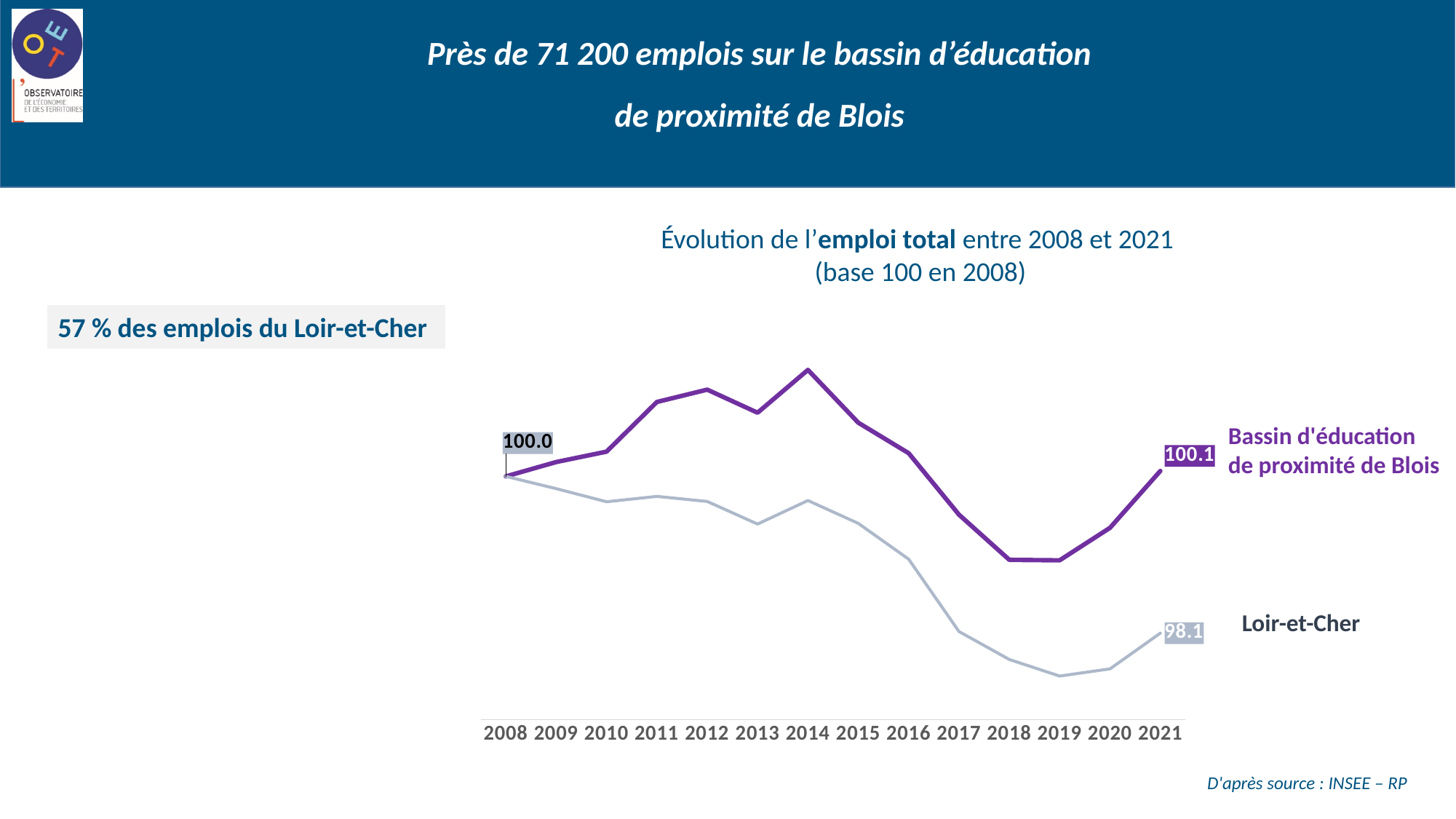
In which year does the Loir-et-Cher series reach its lowest point? 2019 What is the value for Bassin d'éducation de proximité de Blois in 2021? 100.1 What colour is the line for Bassin d'éducation de proximité de Blois? purple Does the Loir-et-Cher series rise or fall between 2016 and 2019? fall What is the difference between the 2021 values for Bassin d'éducation de proximité de Blois and Loir-et-Cher? 2.0 What is the value for Loir-et-Cher in 2021? 98.1 In which year does the Bassin d'éducation de proximité de Blois series reach its highest point? 2014 In 2021, which series has the higher value, Bassin d'éducation de proximité de Blois or Loir-et-Cher? Bassin d'éducation de proximité de Blois What kind of chart is shown on the slide? line chart How many years are shown on the x axis of the chart? 14 How many series does the chart show? 2 What is the value shown for 2008 at the start of the chart? 100.0